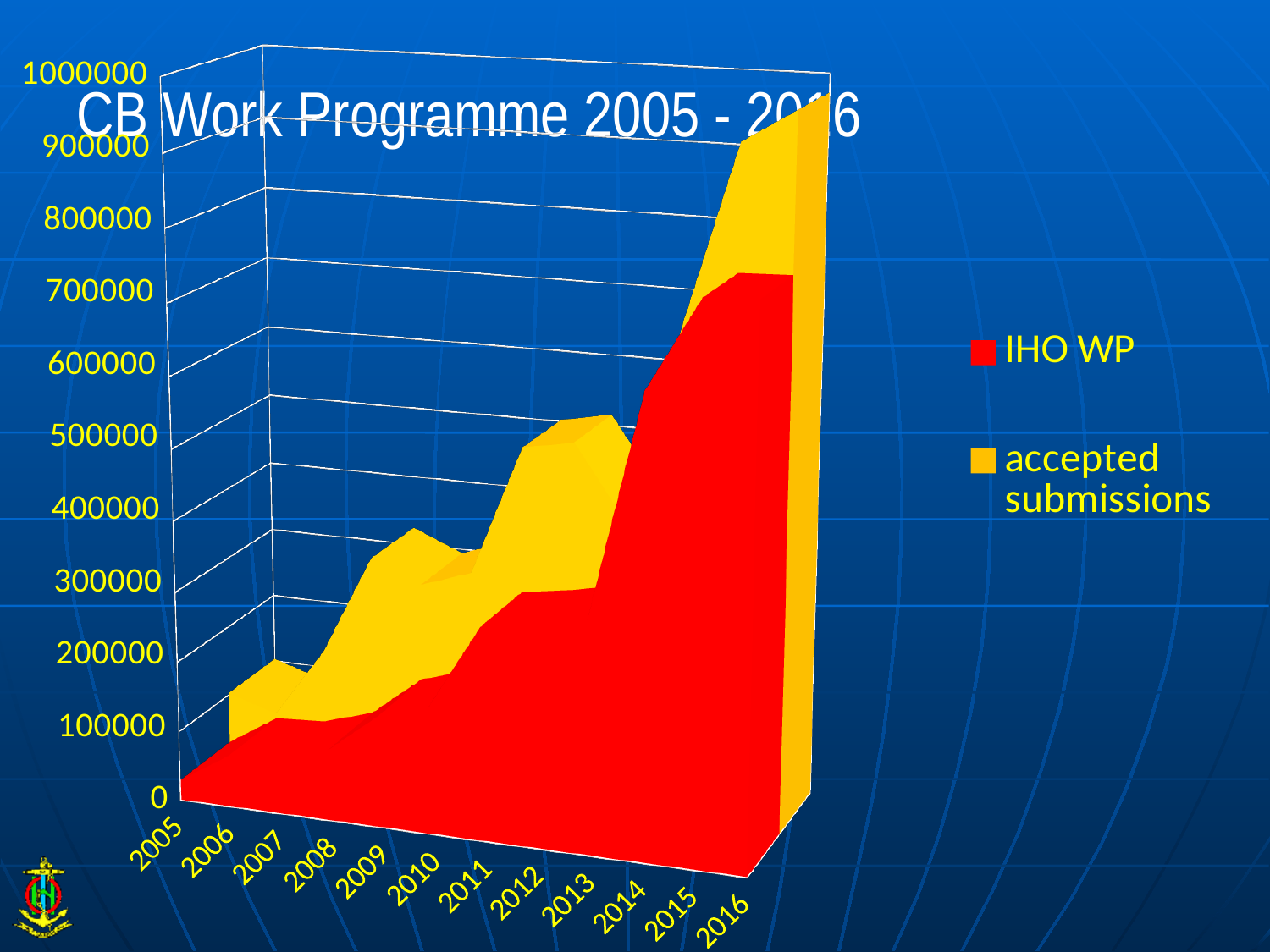
Is the IHO WP value for 2005 greater or less than 100000? less What is the title of the chart? CB Work Programme 2005 - 2016 What kind of chart is shown on the slide? area chart Is the IHO WP value for 2016 greater or less than 500000? greater In 2016, which series has the larger value, IHO WP or accepted submissions? accepted submissions What are the two series named in the legend? IHO WP and accepted submissions How many series does the legend list? 2 How many years are shown along the x axis? 12 In which year is the accepted submissions value highest? 2016 In which year is the IHO WP value lowest? 2005 Do the IHO WP values generally rise or fall from 2005 to 2016? rise